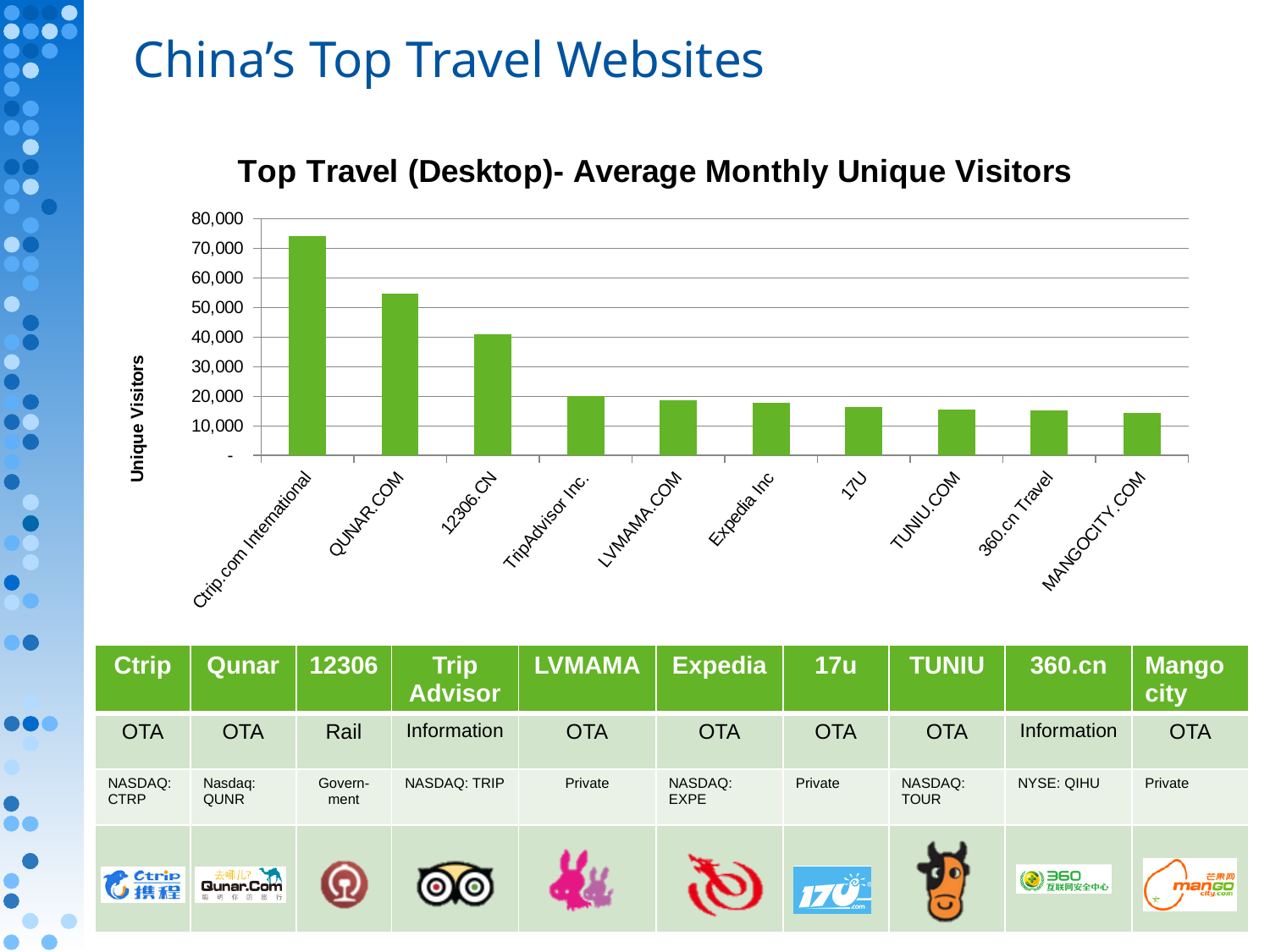
What is the label on the vertical axis of the chart? Unique Visitors Is the value for MANGOCITY.COM greater or less than 10,000? greater Is the value for 12306.CN greater or less than 50,000? less What kind of chart is shown on the slide? Bar chart Which has more unique visitors, QUNAR.COM or 12306.CN? QUNAR.COM Which website has the highest average monthly unique visitors? Ctrip.com International What is the title of the chart? Top Travel (Desktop)- Average Monthly Unique Visitors Is the value for Ctrip.com International greater or less than 70,000? greater Do the values rise or fall moving from left to right along the x axis? Fall How many websites are plotted in the chart? 10